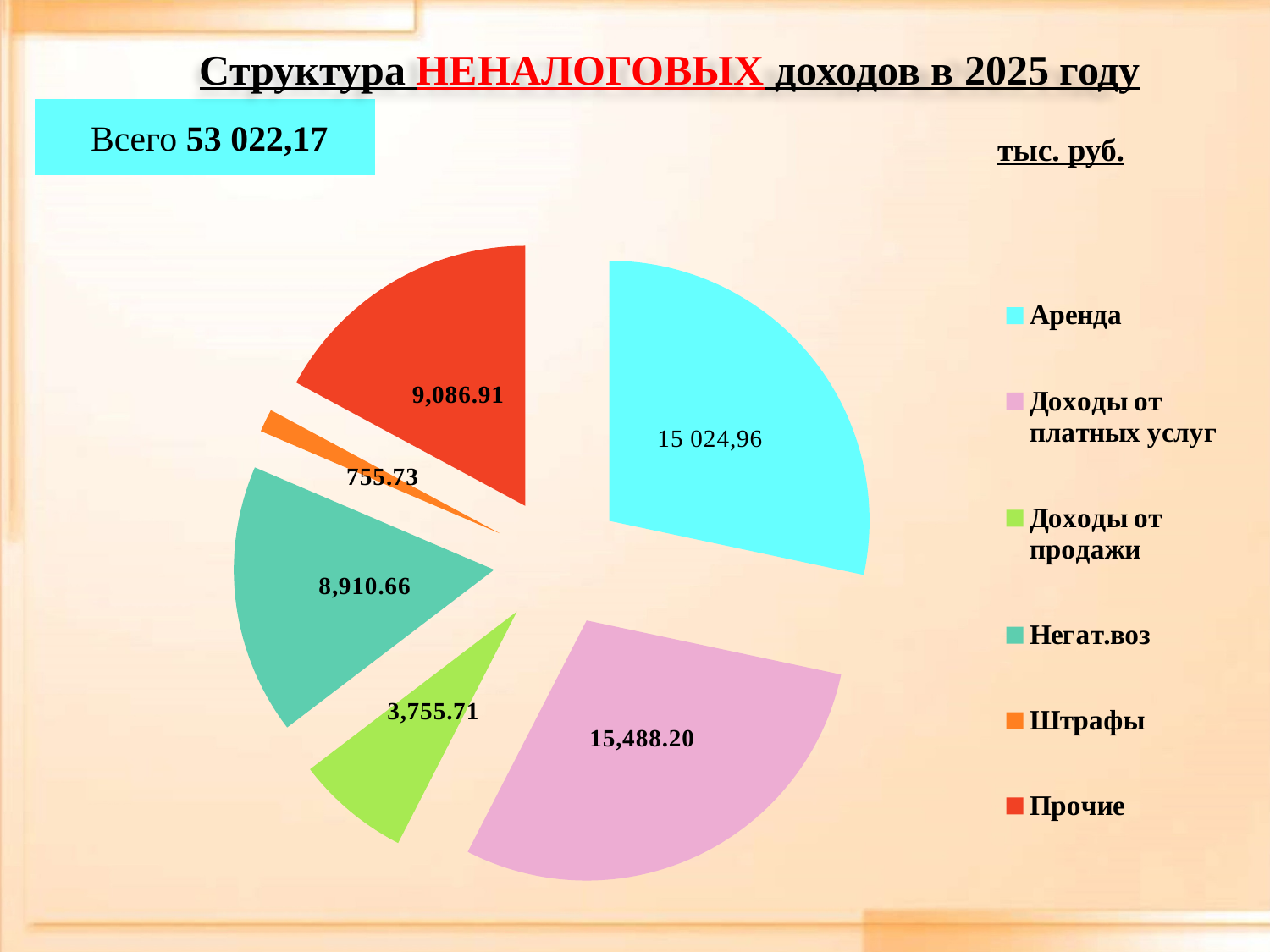
What total (Всего) is shown on the slide? 53 022,17 What is the value for Штрафы? 755.73 How many slices does the pie chart have? 6 Which is larger: Прочие or Негат.воз? Прочие What kind of chart is shown on the slide? Pie chart What is the value for Аренда? 15 024,96 What is the title of the chart on the slide? Структура НЕНАЛОГОВЫХ доходов в 2025 году What is the difference between Негат.воз and Доходы от продажи? 5,154.95 Which category has the largest value in the pie chart? Доходы от платных услуг What is the value for Доходы от платных услуг? 15,488.20 What is the value for Негат.воз? 8,910.66 Which category has the smallest slice of the pie? Штрафы